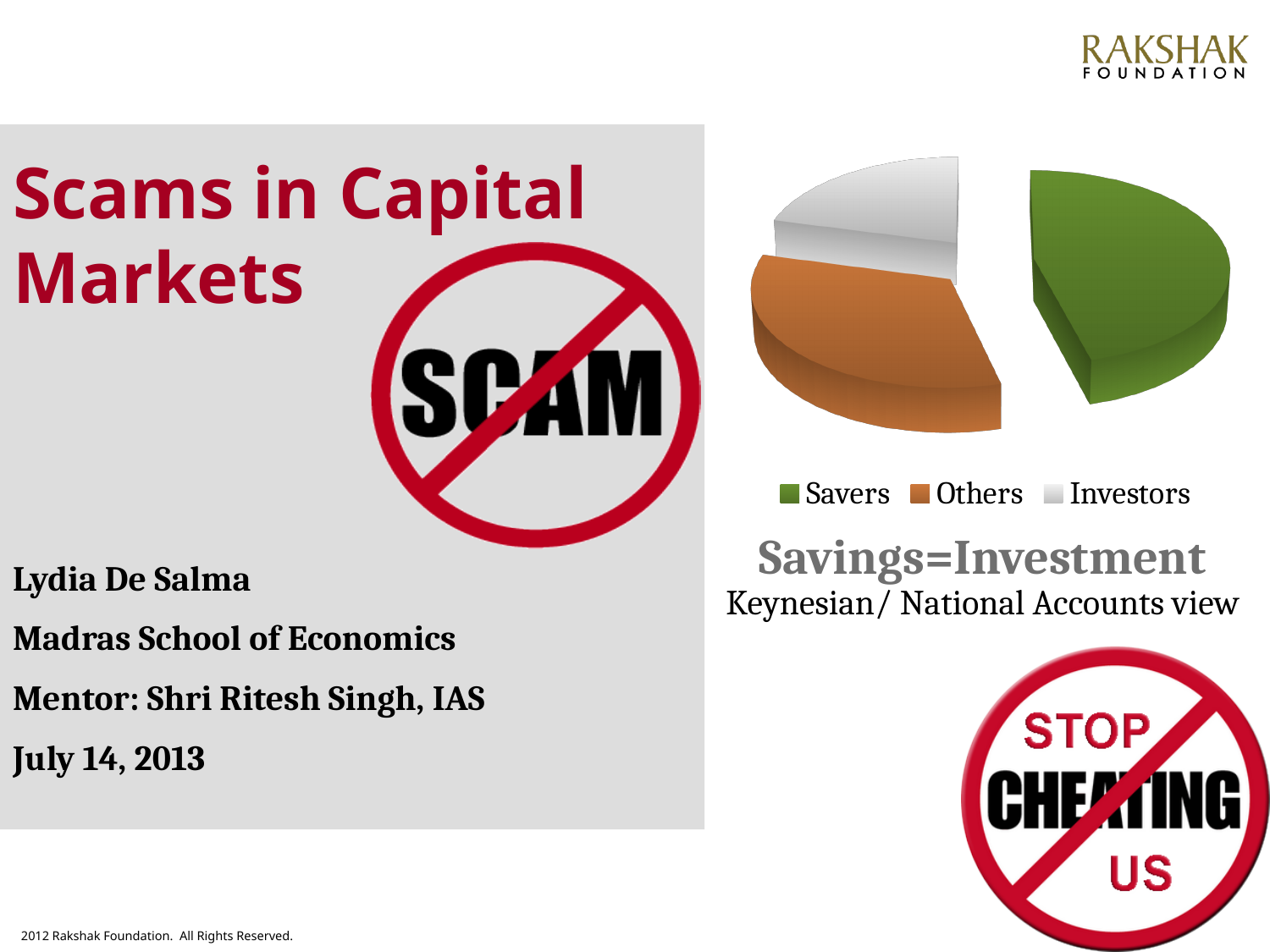
How many slices does the pie chart have? 3 Which slice is larger in the pie chart, Savers or Others? Savers Which slice is larger in the pie chart, Savers or Investors? Savers Which slice is larger in the pie chart, Others or Investors? Others Which category has the largest slice of the pie chart? Savers What are the three categories listed in the pie chart's legend? Savers, Others, Investors What kind of chart is shown on the slide? Pie chart Which category has the smallest slice of the pie chart? Investors How many entries does the pie chart's legend list? 3 What colour is the Savers slice in the pie chart? Green